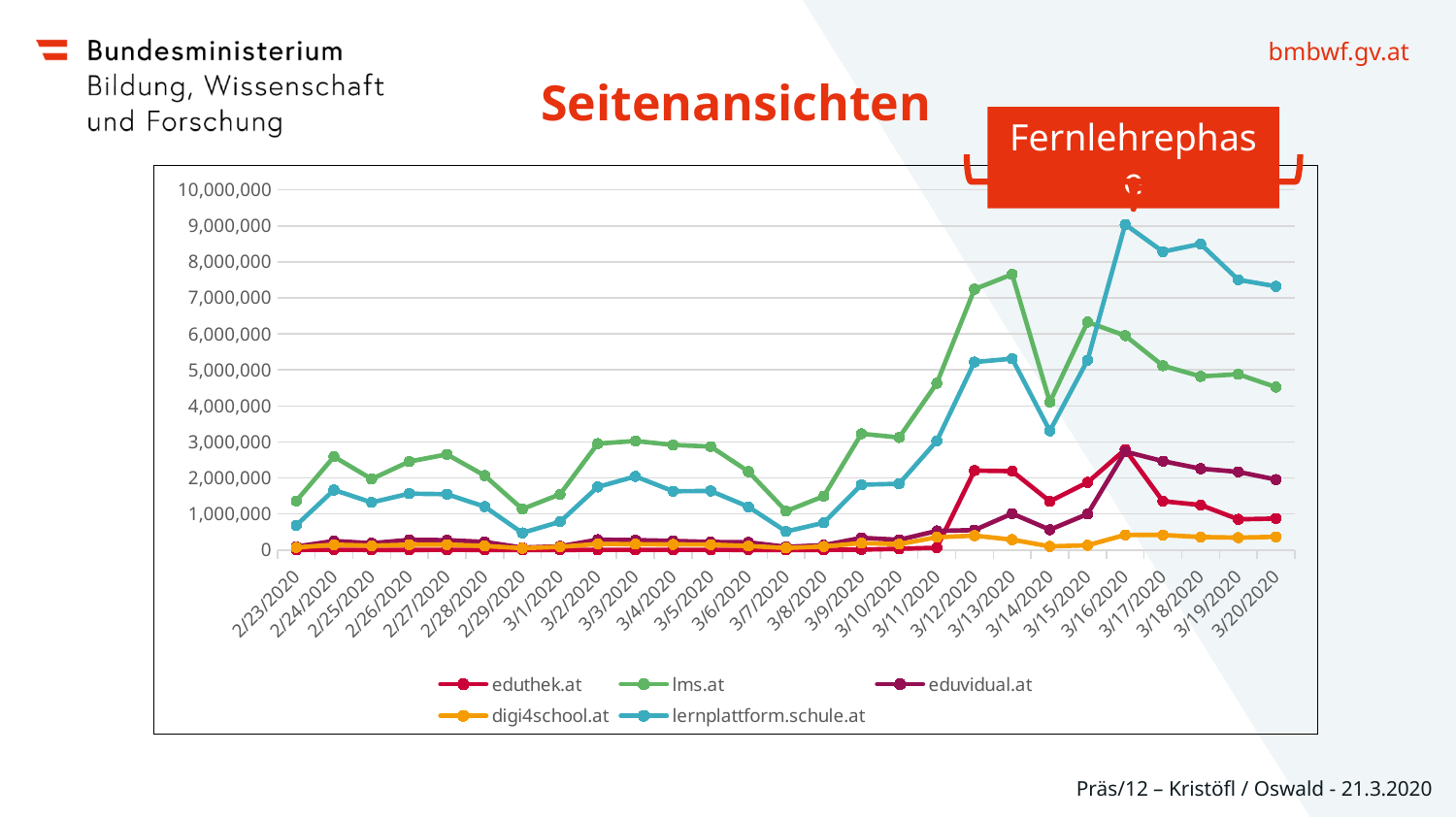
What is the title of the chart? Seitenansichten On 3/13/2020, which is higher: lms.at or lernplattform.schule.at? lms.at Which series has the lowest value on 3/20/2020? digi4school.at Is the value for lms.at on 2/23/2020 greater or less than 2,000,000? less How many dates are shown along the x axis? 27 Is the value for lernplattform.schule.at on 3/16/2020 greater or less than 8,000,000? greater How many series does the legend list? 5 What kind of chart is shown on the slide? line chart Which series has the highest value on 3/16/2020? lernplattform.schule.at On 3/20/2020, which is higher: lms.at or lernplattform.schule.at? lernplattform.schule.at Is the value for lms.at on 3/12/2020 greater or less than 6,000,000? greater Does the lernplattform.schule.at line rise or fall from 3/16/2020 to 3/20/2020? fall